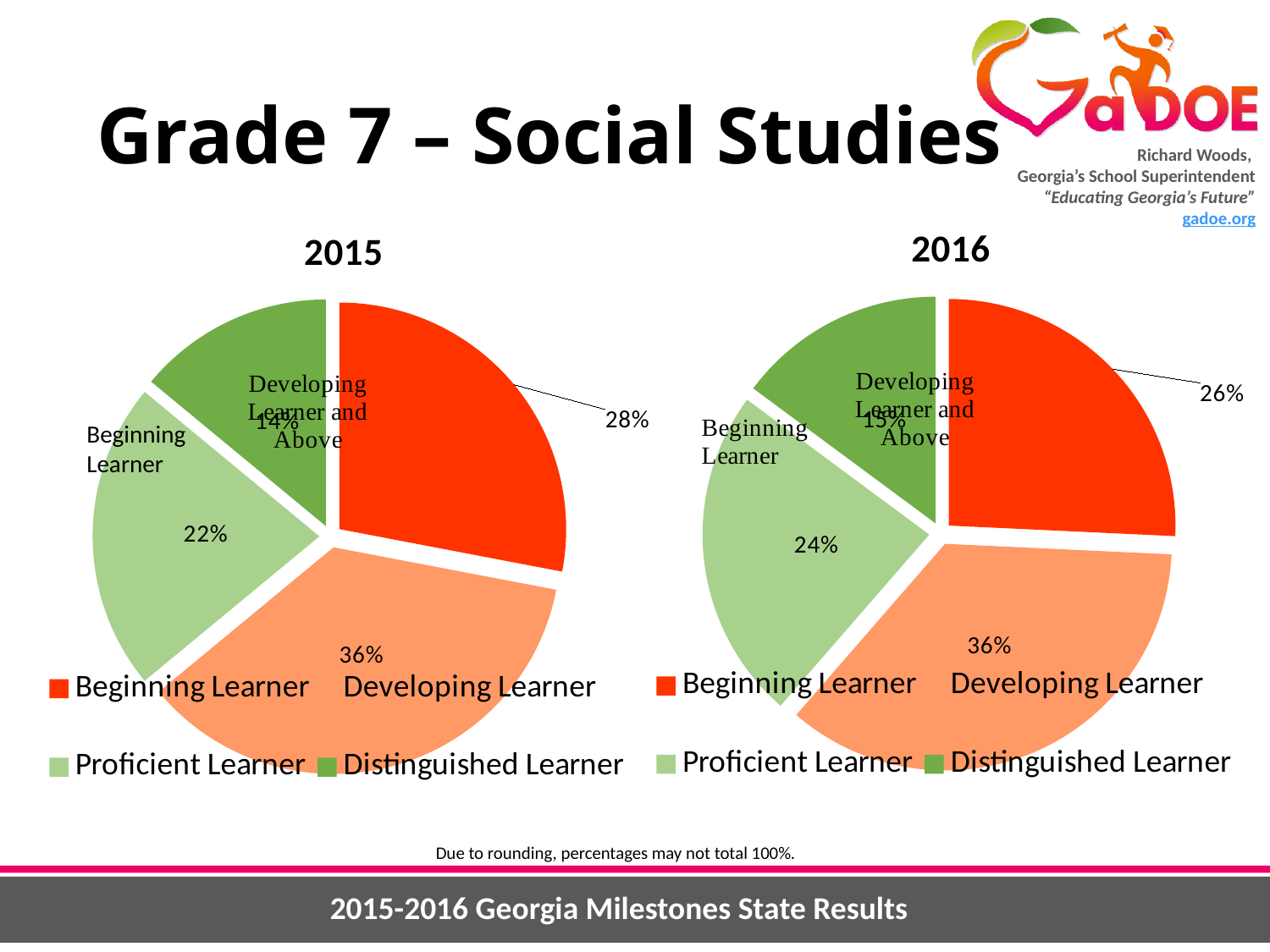
How many categories does the 2015 pie chart show? 4 In the 2016 pie chart, what percentage is shown for Distinguished Learner? 15% In the 2015 pie chart, which category has the largest share? Developing Learner What kind of chart is used for the 2016 data? Pie chart What is the difference between the Beginning Learner percentages in the 2015 and 2016 pie charts? 2% In the 2016 pie chart, which category has the smallest share? Distinguished Learner In the 2016 pie chart, what percentage is shown for Proficient Learner? 24% What is the title of the chart on the left? 2015 In the 2015 pie chart, what percentage is shown for Developing Learner? 36% Which is larger: Proficient Learner in the 2015 pie chart or Proficient Learner in the 2016 pie chart? 2016 In the 2015 pie chart, what percentage is shown for Beginning Learner? 28% In the 2016 pie chart, what is the difference between the Developing Learner and Proficient Learner percentages? 12%